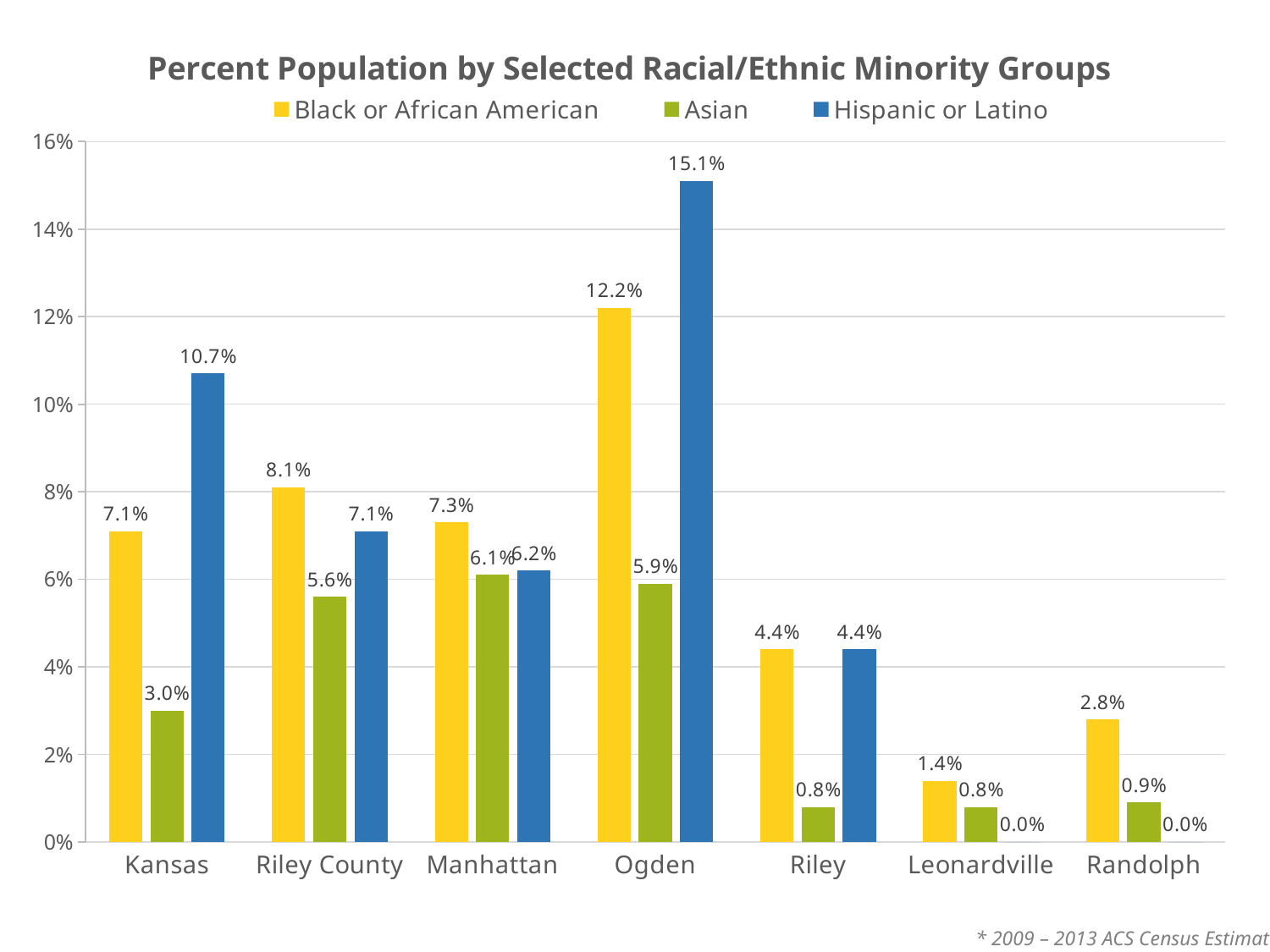
What is the Asian percentage for Kansas? 3.0% Is the Black or African American value for Ogden greater or less than 10%? greater What is the Hispanic or Latino percentage for Ogden? 15.1% What is the title of the chart? Percent Population by Selected Racial/Ethnic Minority Groups What is the difference between the Hispanic or Latino percentage for Kansas and for Riley County? 3.6% How many categories are shown on the x axis? 7 What is the Black or African American percentage for Riley County? 8.1% Which category has the highest Hispanic or Latino percentage? Ogden Which category has the lowest Black or African American percentage? Leonardville How many series does the legend list? 3 What kind of chart is shown on the slide? Bar chart Which is larger for Manhattan: the Black or African American percentage or the Asian percentage? Black or African American